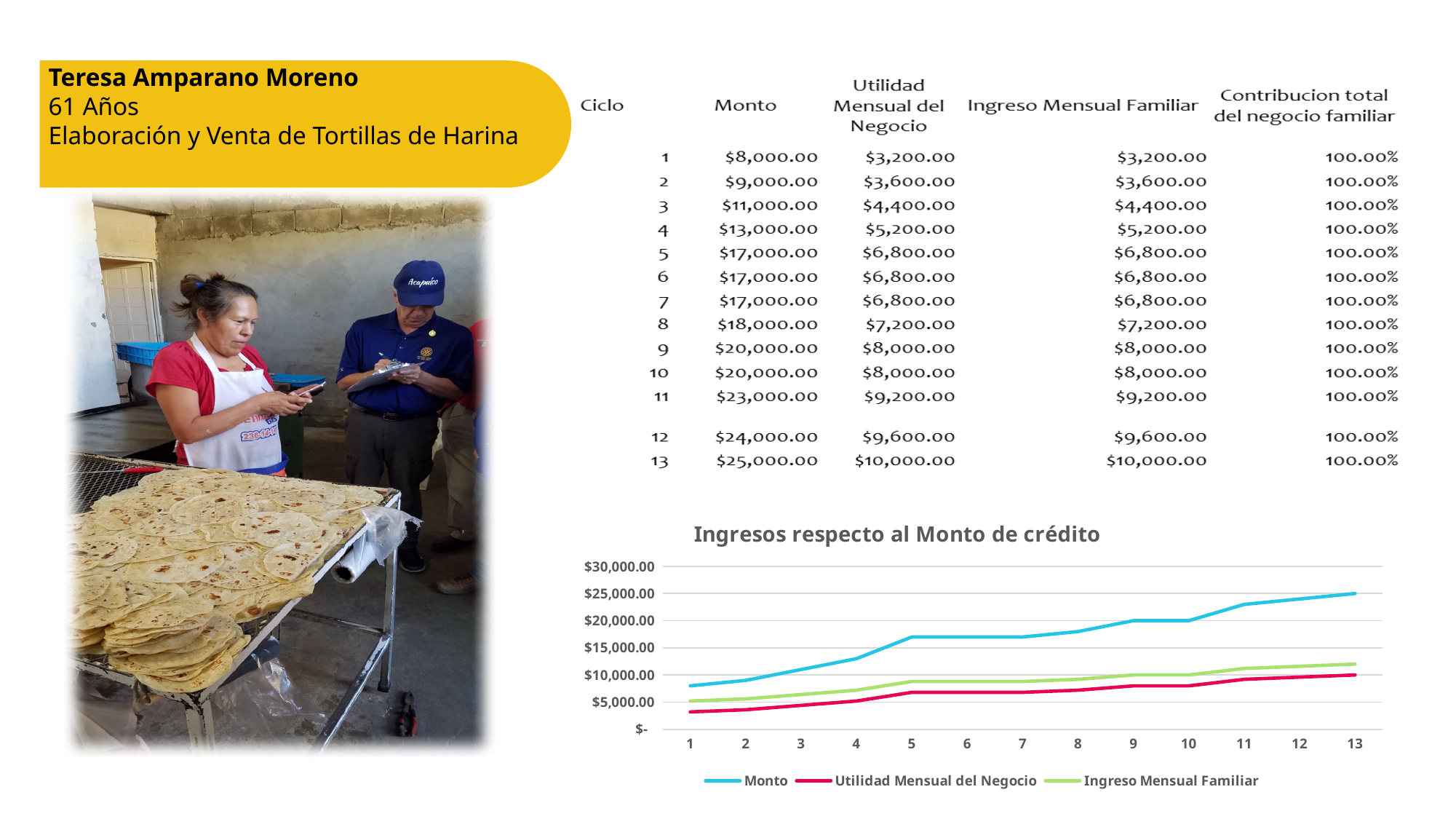
What kind of chart is "Ingresos respecto al Monto de crédito"? line chart At which cycle is the Monto series lowest? 1 Which series is higher at cycle 9, Monto or Utilidad Mensual del Negocio? Monto At which cycle is the Monto series highest? 13 What is the Monto value at cycle 1? $8,000.00 What colour is the Monto line in the chart? blue How many cycles (points) are plotted along the x axis of the chart? 13 Is the Monto value at cycle 5 greater or less than $15,000.00? greater How many series does the legend of the chart list? 3 Does the Monto series rise or fall from cycle 1 to cycle 13? rises What is the Monto value at cycle 13? $25,000.00 What is the difference between the Monto at cycle 13 and the Monto at cycle 1? $17,000.00